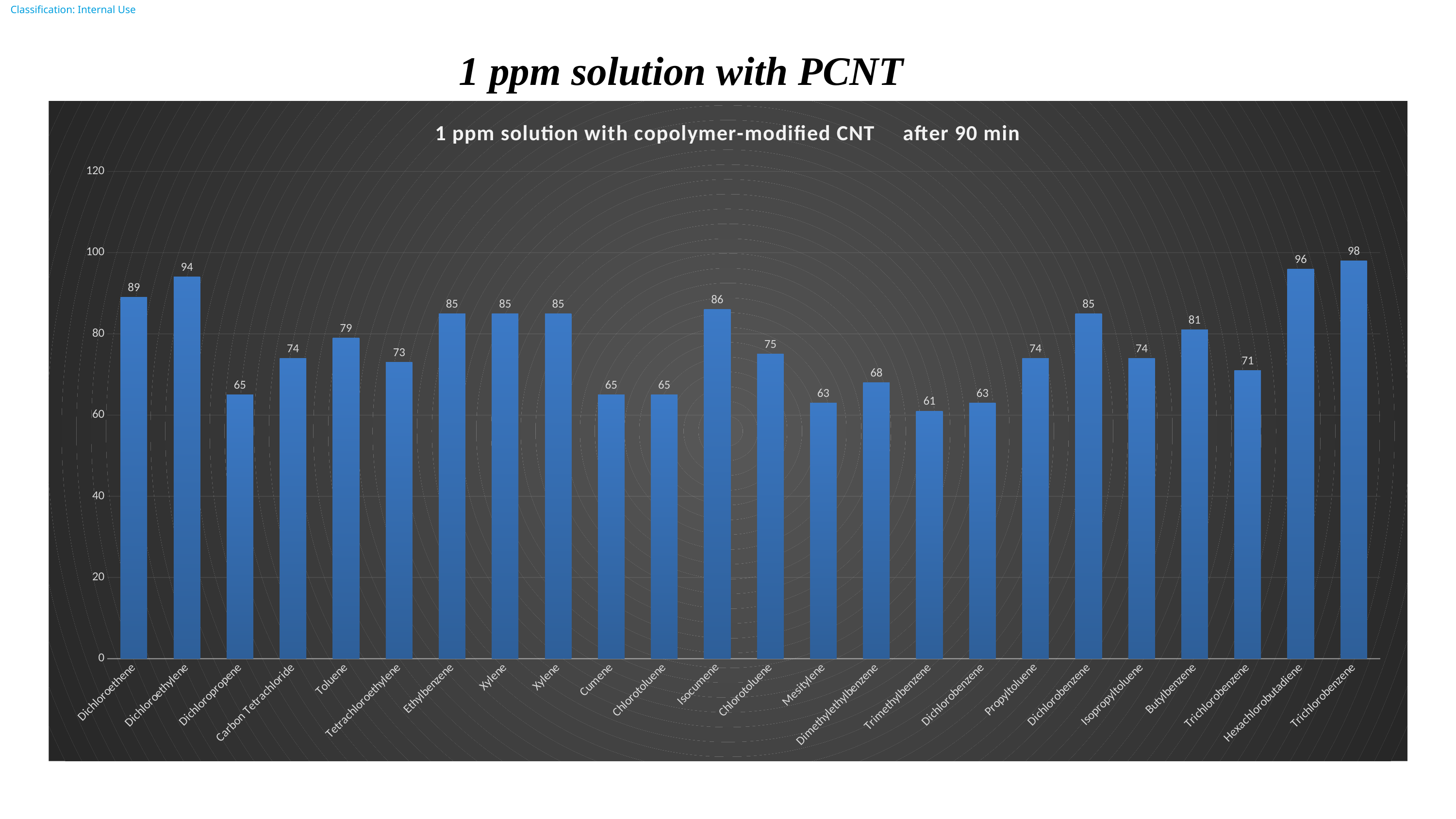
What is the difference between the values for Dichloroethylene and Dichloropropene? 29 What is the value for Hexachlorobutadiene? 96 How many bars are plotted in the chart? 24 What is the value for Isocumene? 86 Which category has the lowest value? Trimethylbenzene Is the value for Cumene greater or less than 80? less Which has a larger value, Butylbenzene or Mesitylene? Butylbenzene What is the value for Dichloroethylene? 94 What is the highest value shown in the chart? 98 What kind of chart is shown on the slide? bar chart What is the value for Toluene? 79 What is the value for Carbon Tetrachloride? 74